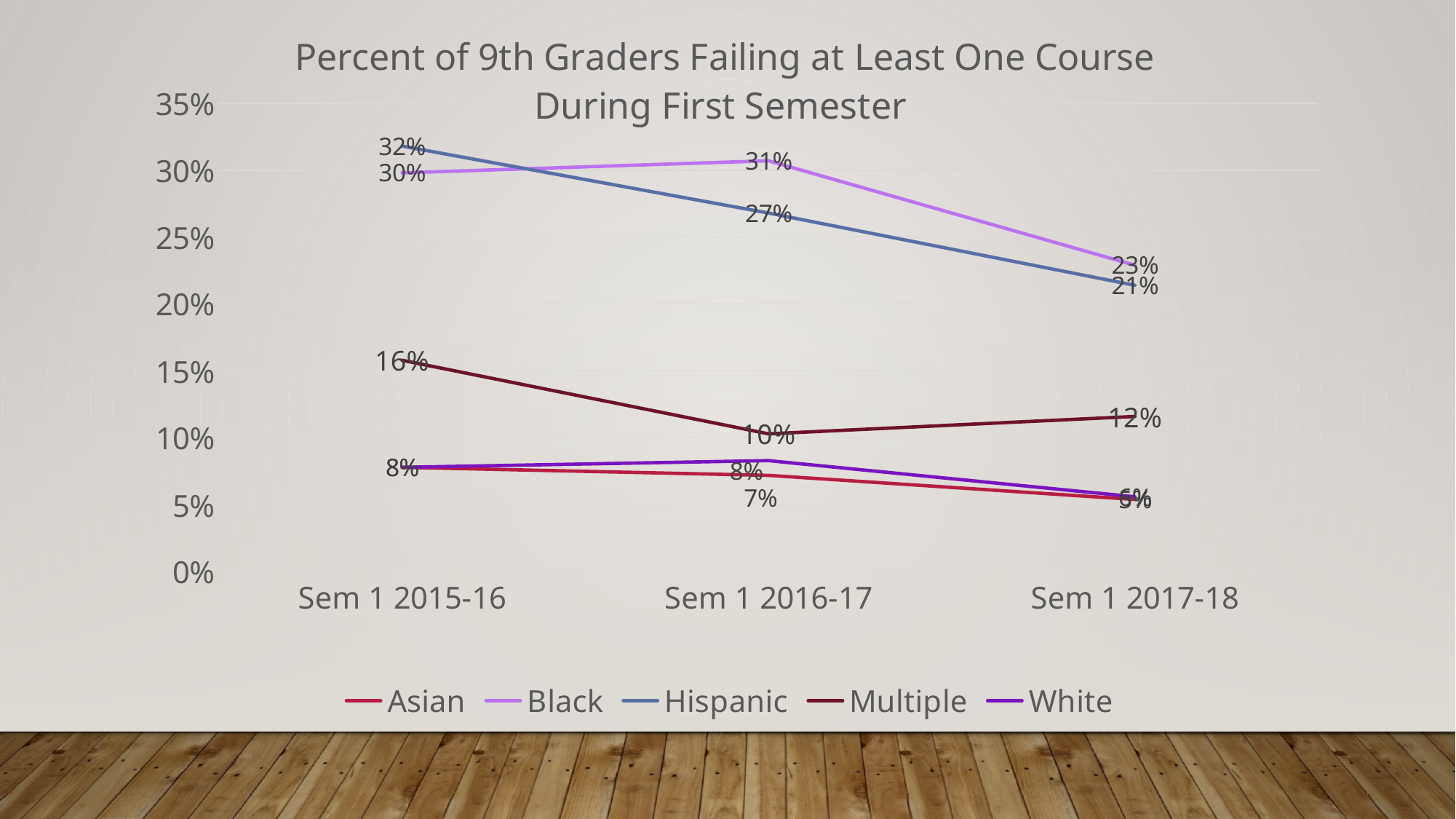
By how many percentage points did the Hispanic value drop from Sem 1 2015-16 to Sem 1 2017-18? 11 percentage points What percent of Hispanic 9th graders failed at least one course in Sem 1 2015-16? 32% Which group had the highest percent failing in Sem 1 2015-16? Hispanic What is the value for the Multiple group in Sem 1 2017-18? 12% What kind of chart is shown on the slide? Line chart How many semesters are plotted along the x axis? 3 How many series does the legend list? 5 What is the value for Black students in Sem 1 2016-17? 31% In Sem 1 2016-17, which was higher: Black or Hispanic? Black Which group had the highest percent failing in Sem 1 2017-18? Black What is the value for the Multiple group in Sem 1 2016-17? 10% Does the Hispanic line rise or fall across the three semesters? Fall